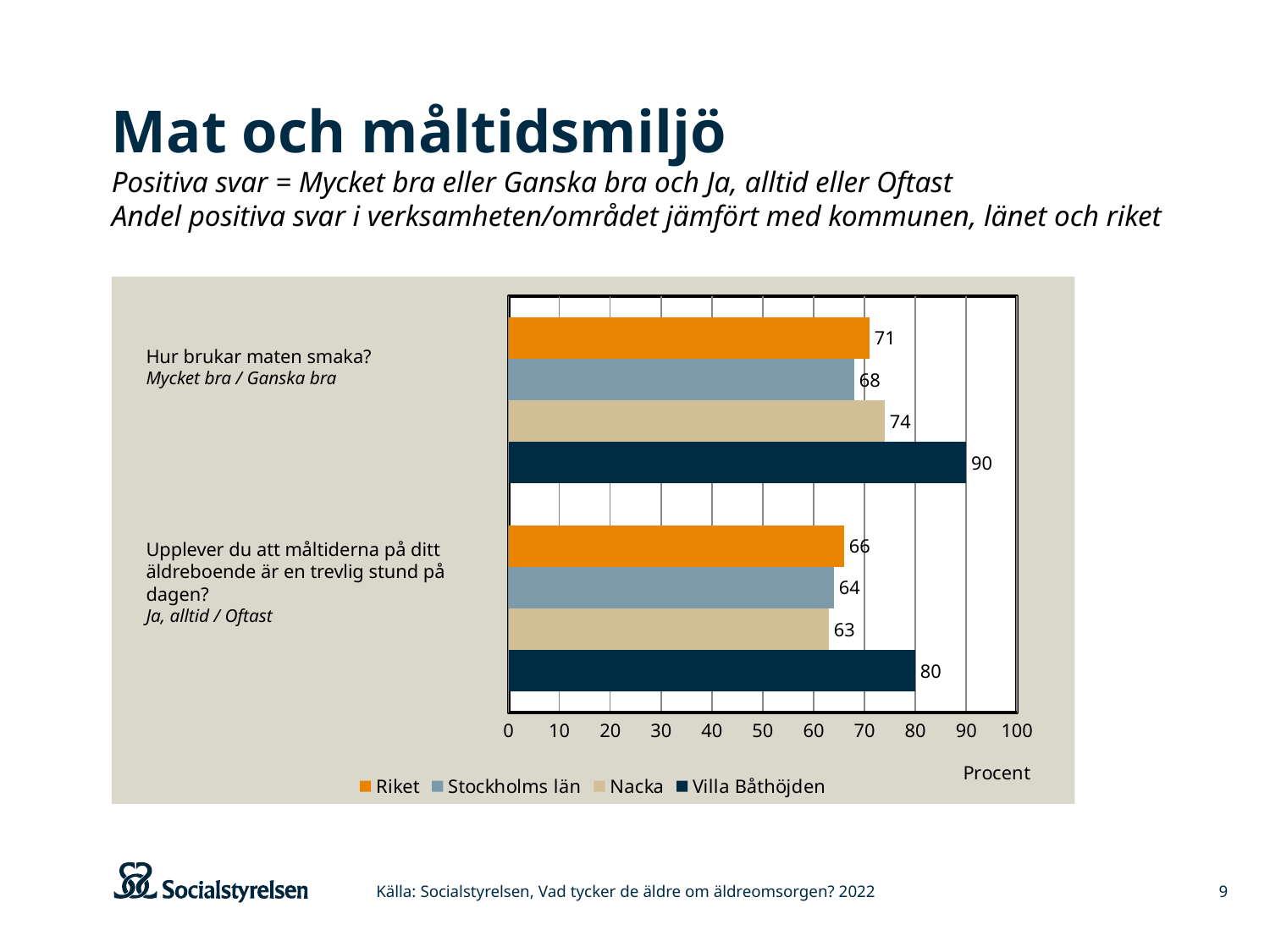
What unit label is shown on the x axis of the chart? Procent Is the value for Villa Båthöjden for "Upplever du att måltiderna på ditt äldreboende är en trevlig stund på dagen?" greater or less than 70? greater What is the value for Stockholms län for the question "Upplever du att måltiderna på ditt äldreboende är en trevlig stund på dagen?"? 64 Which series has the lowest value for "Hur brukar maten smaka?"? Stockholms län What is the difference between Villa Båthöjden and Riket for "Upplever du att måltiderna på ditt äldreboende är en trevlig stund på dagen?"? 14 What is the value for Villa Båthöjden for the question "Hur brukar maten smaka?"? 90 Which series has the highest value for "Upplever du att måltiderna på ditt äldreboende är en trevlig stund på dagen?"? Villa Båthöjden What kind of chart is shown on the slide? Bar chart For "Hur brukar maten smaka?", which is larger: Nacka or Riket? Nacka What is the value for Riket for the question "Hur brukar maten smaka?"? 71 What is the difference between Villa Båthöjden and Nacka for "Hur brukar maten smaka?"? 16 How many series does the legend list? 4